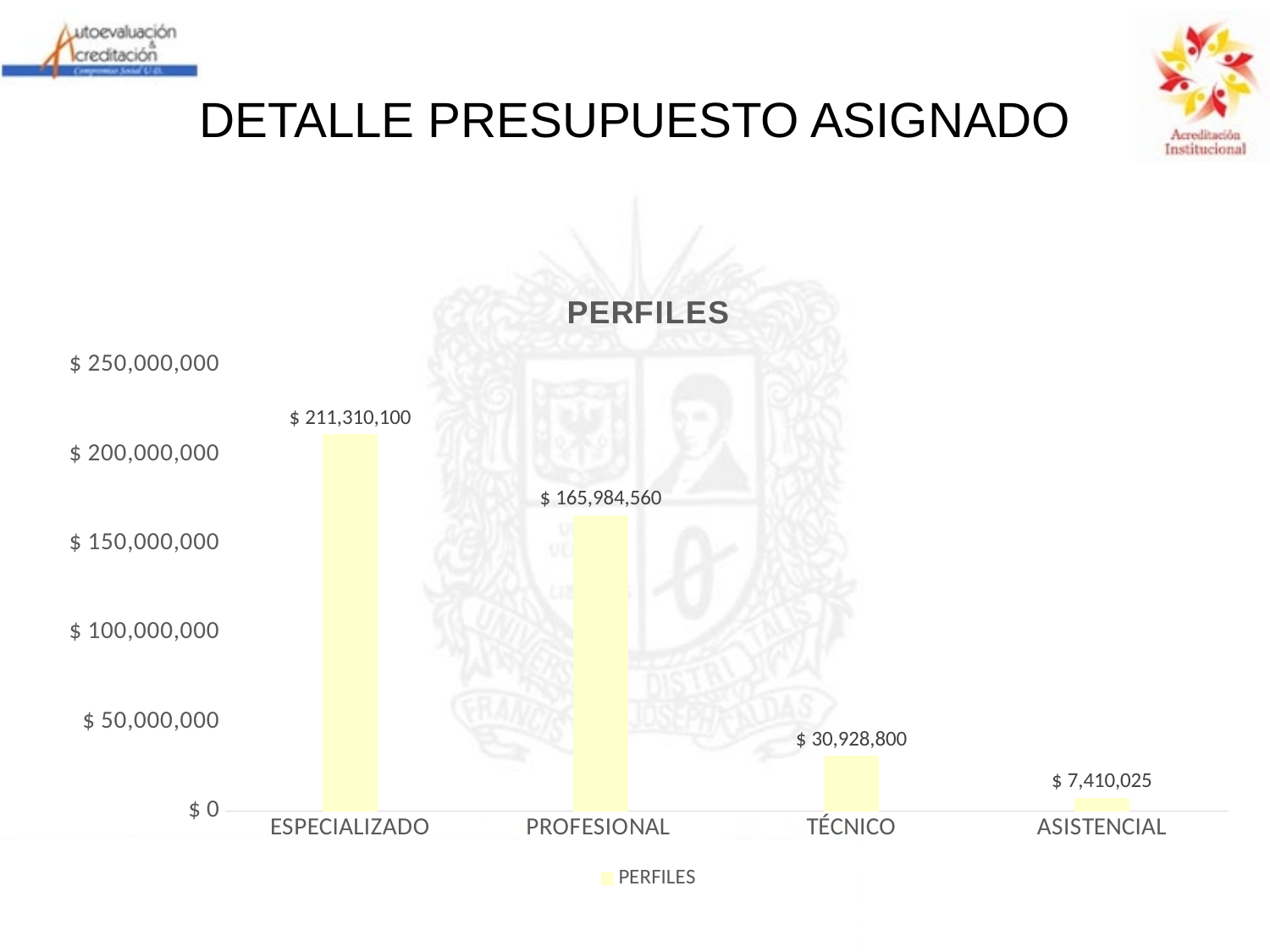
How many categories are shown on the x axis? 4 What is the value for ASISTENCIAL? $ 7,410,025 What is the value for ESPECIALIZADO? $ 211,310,100 Which category has the lowest value? ASISTENCIAL What is the value for PROFESIONAL? $ 165,984,560 What kind of chart is shown on the slide? bar chart What is the value for TÉCNICO? $ 30,928,800 Which category has the highest value? ESPECIALIZADO What is the difference between the values for ESPECIALIZADO and PROFESIONAL? $ 45,325,540 How many series does the legend list? 1 Is the value for PROFESIONAL greater or less than $ 150,000,000? greater Which is larger, the value for TÉCNICO or the value for ASISTENCIAL? TÉCNICO